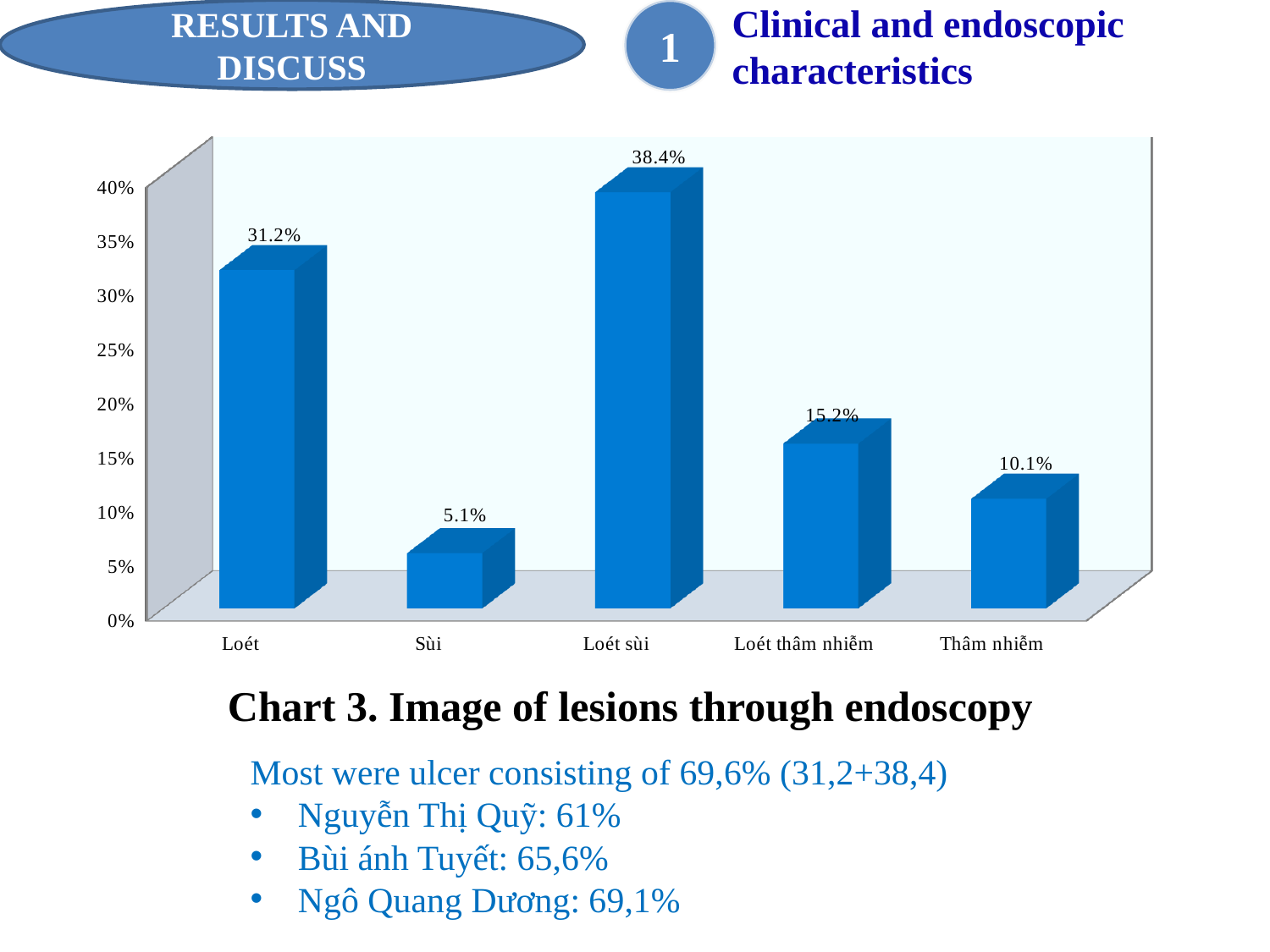
Which category has the lowest value? Sùi What is the title of the chart? Chart 3. Image of lesions through endoscopy Which is larger, the value for Loét thâm nhiễm or the value for Thâm nhiễm? Loét thâm nhiễm What is the value for Thâm nhiễm? 10.1% Which category has the highest value? Loét sùi Is the value for Loét sùi greater or less than 35%? greater What is the difference between the values for Loét sùi and Loét? 7.2% What kind of chart is shown on the slide? bar chart What is the value for Loét thâm nhiễm? 15.2% What is the value for Sùi? 5.1% What is the value for Loét? 31.2% How many categories are shown on the x axis? 5